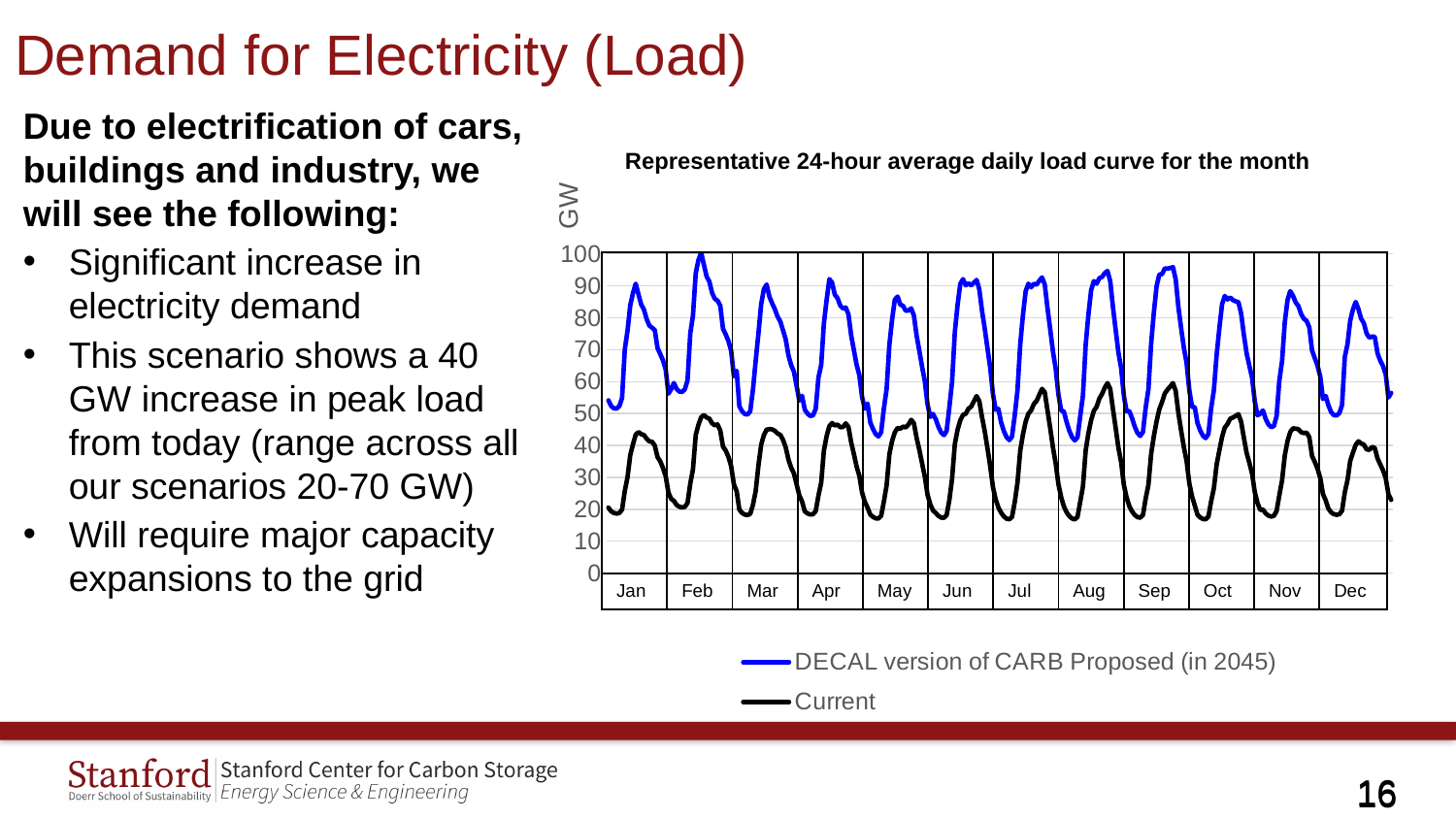
What is the title of the chart? Representative 24-hour average daily load curve for the month Is the peak value of the Current series in Jan greater or less than 50? less What unit is shown on the y axis of the chart? GW What kind of chart is shown on the slide? Line chart Is the lowest value of the DECAL version of CARB Proposed (in 2045) series in Jan greater or less than 40? greater Which series has higher values throughout the year, DECAL version of CARB Proposed (in 2045) or Current? DECAL version of CARB Proposed (in 2045) Is the lowest value of the Current series in Jul greater or less than 30? less How many months are shown along the x axis of the chart? 12 How many series does the chart's legend list? 2 In which month does the DECAL version of CARB Proposed (in 2045) series reach its highest peak? Feb